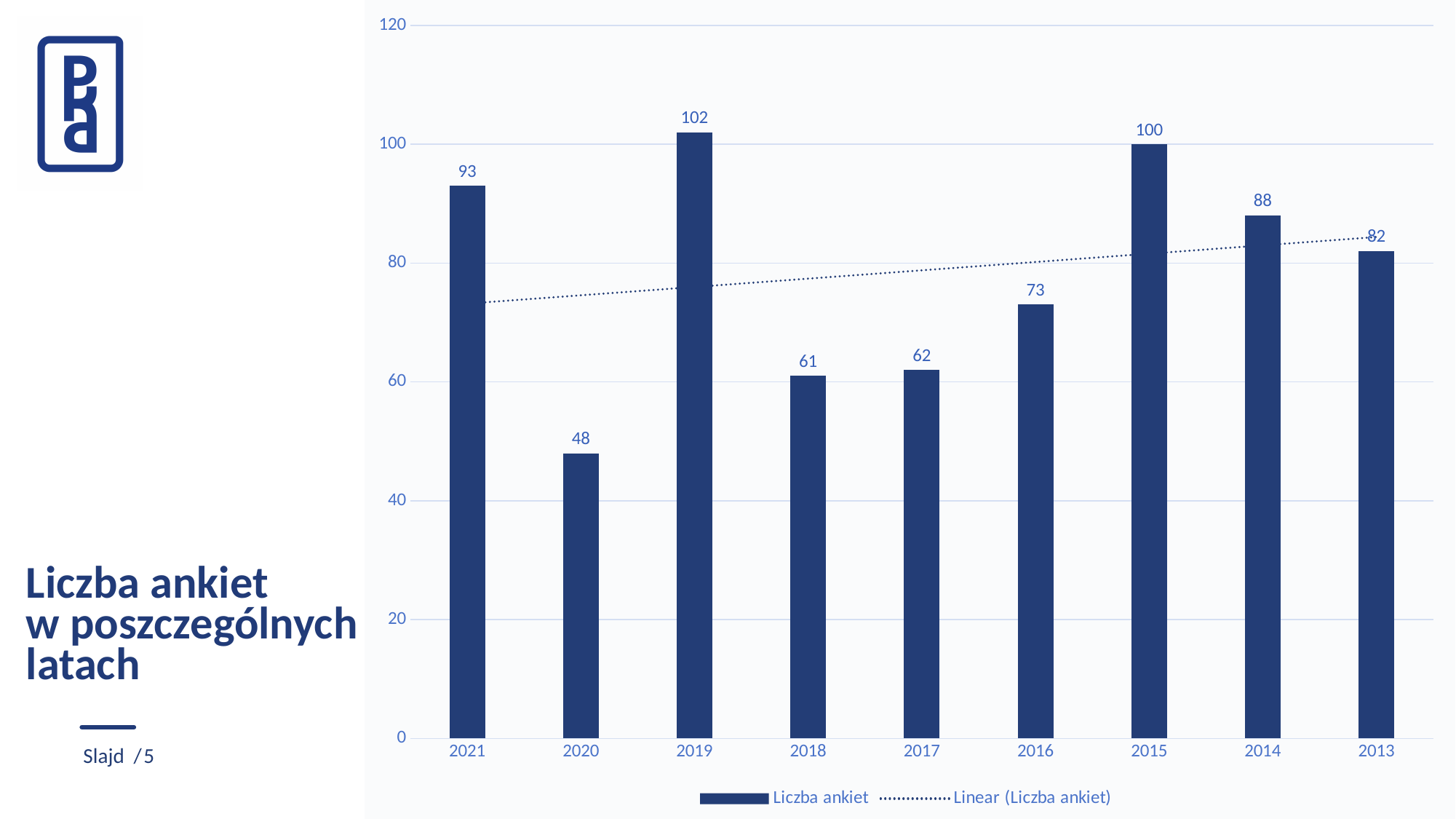
What is the value for 2016? 73 What kind of chart is shown? bar chart Is the value for 2013 greater or less than 80? greater Which is larger, the value for 2015 or the value for 2014? 2015 Which year has the highest value? 2019 What is the difference between the values for 2021 and 2020? 45 What is the value for 2019? 102 What is the title of the slide? Liczba ankiet w poszczególnych latach How many years are shown on the x axis? 9 How many entries does the legend list? 2 What is the value for 2020? 48 Which year has the lowest value? 2020